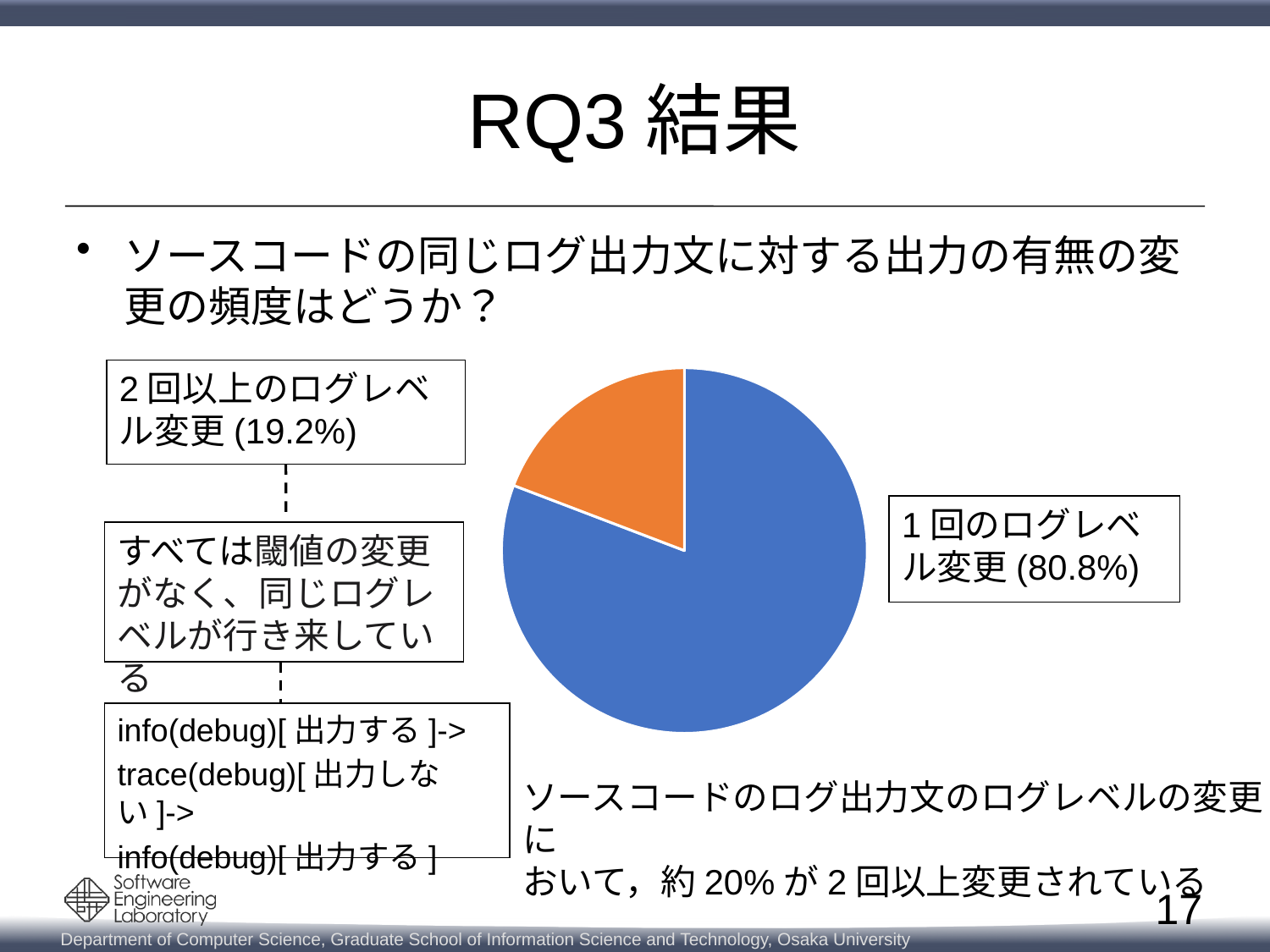
What is the difference in percentage points between the share for 1回のログレベル変更 and the share for 2回以上のログレベル変更? 61.6% Which is larger, the share for 1回のログレベル変更 or the share for 2回以上のログレベル変更? 1回のログレベル変更 Which slice of the pie chart is the largest? 1回のログレベル変更 Which slice of the pie chart is the smallest? 2回以上のログレベル変更 What share of the pie does 2回以上のログレベル変更 represent? 19.2% How many slices does the pie chart have? 2 What share of the pie does 1回のログレベル変更 represent? 80.8% What colour is the slice for 2回以上のログレベル変更? orange What kind of chart is shown on the slide? pie chart What colour is the slice for 1回のログレベル変更? blue